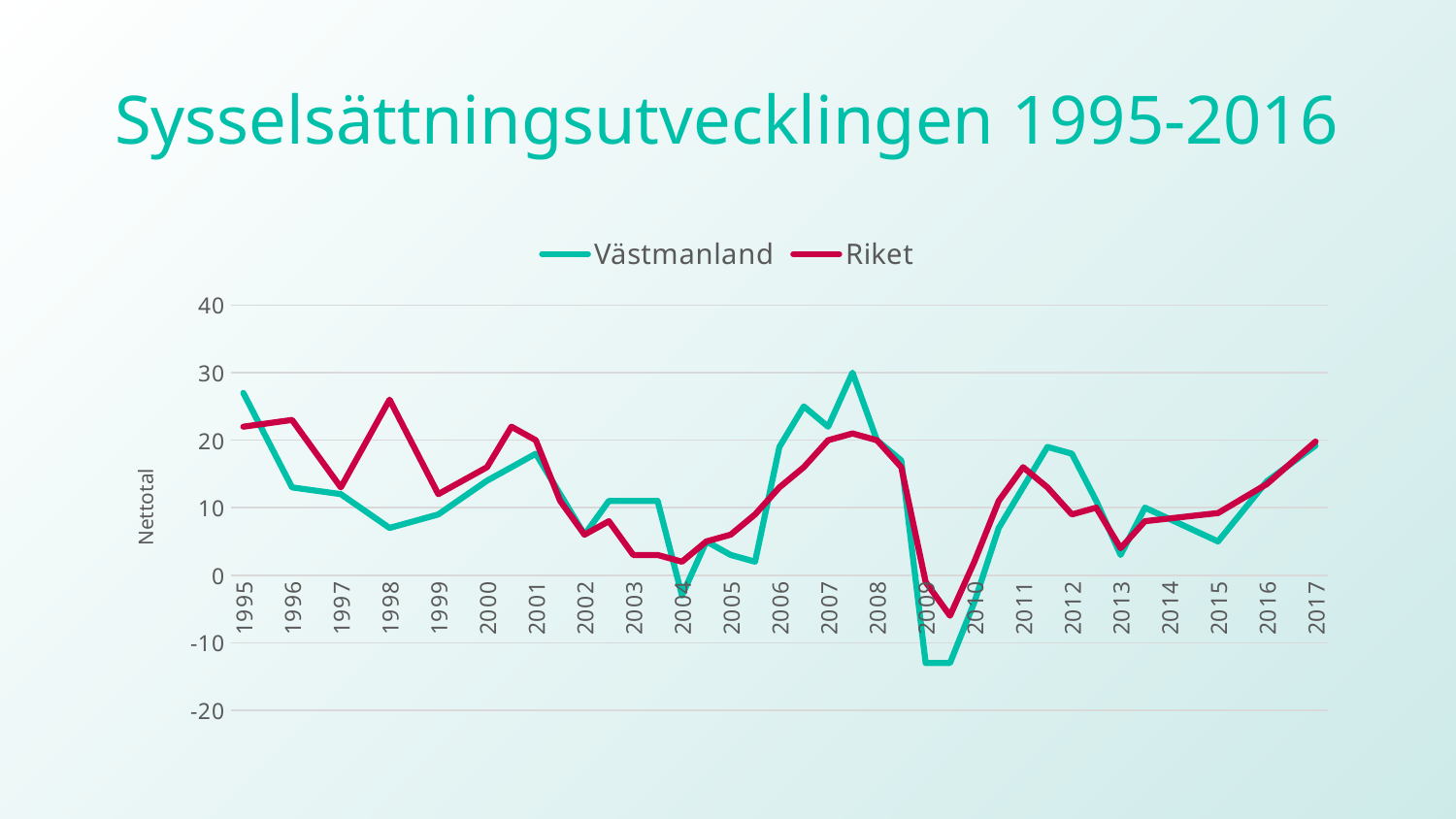
What are the names of the two series in the legend? Västmanland and Riket Is the value for Riket in 1998 greater or less than 20? greater What is the label on the vertical axis? Nettotal In 1998, which series has the higher value, Västmanland or Riket? Riket How many series does the legend list? 2 How many year labels are shown along the x axis? 23 Is the lowest point of the Västmanland line greater or less than -10? less What kind of chart is shown on the slide? Line chart Is the value for Västmanland in 1995 greater or less than 20? greater Do the values for both series rise or fall between 2013 and 2017? rise In 1995, which series has the higher value, Västmanland or Riket? Västmanland